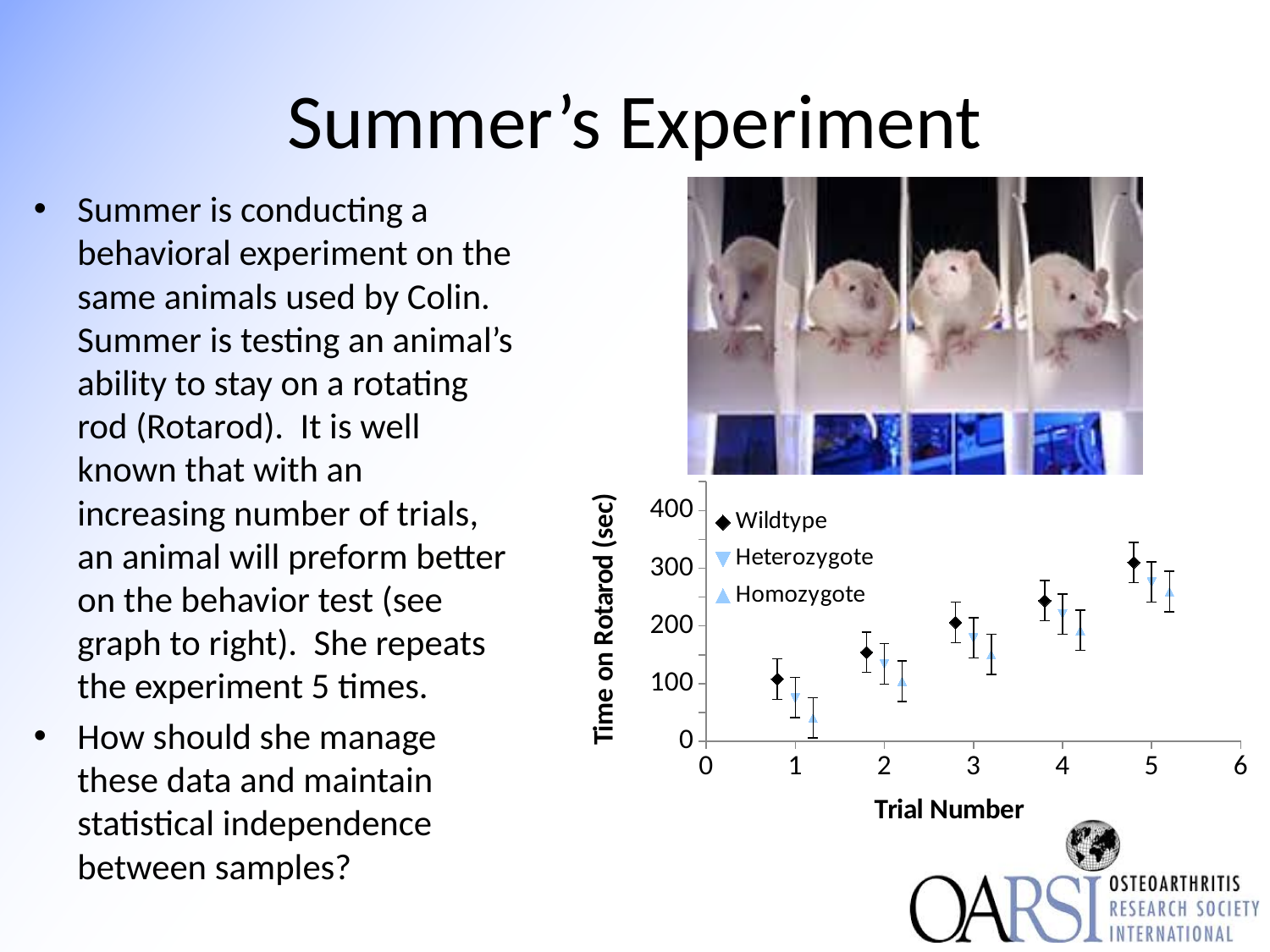
What kind of chart is shown on the slide? scatter chart Is the Wildtype value at trial 5 greater or less than 200? greater Is the Homozygote value at trial 1 greater or less than 100? less Do the Wildtype values rise or fall as the trial number increases? rise How many series does the chart legend list? 3 How many trials are plotted for each series in the chart? 5 Is the Heterozygote value at trial 5 greater or less than 200? greater Which series are listed in the chart legend? Wildtype, Heterozygote, Homozygote What is the title of the chart's y axis? Time on Rotarod (sec) At trial 1, which series has the larger value, Wildtype or Homozygote? Wildtype For the Wildtype series, which is larger, the value at trial 1 or the value at trial 5? trial 5 Do the Homozygote values rise or fall as the trial number increases? rise